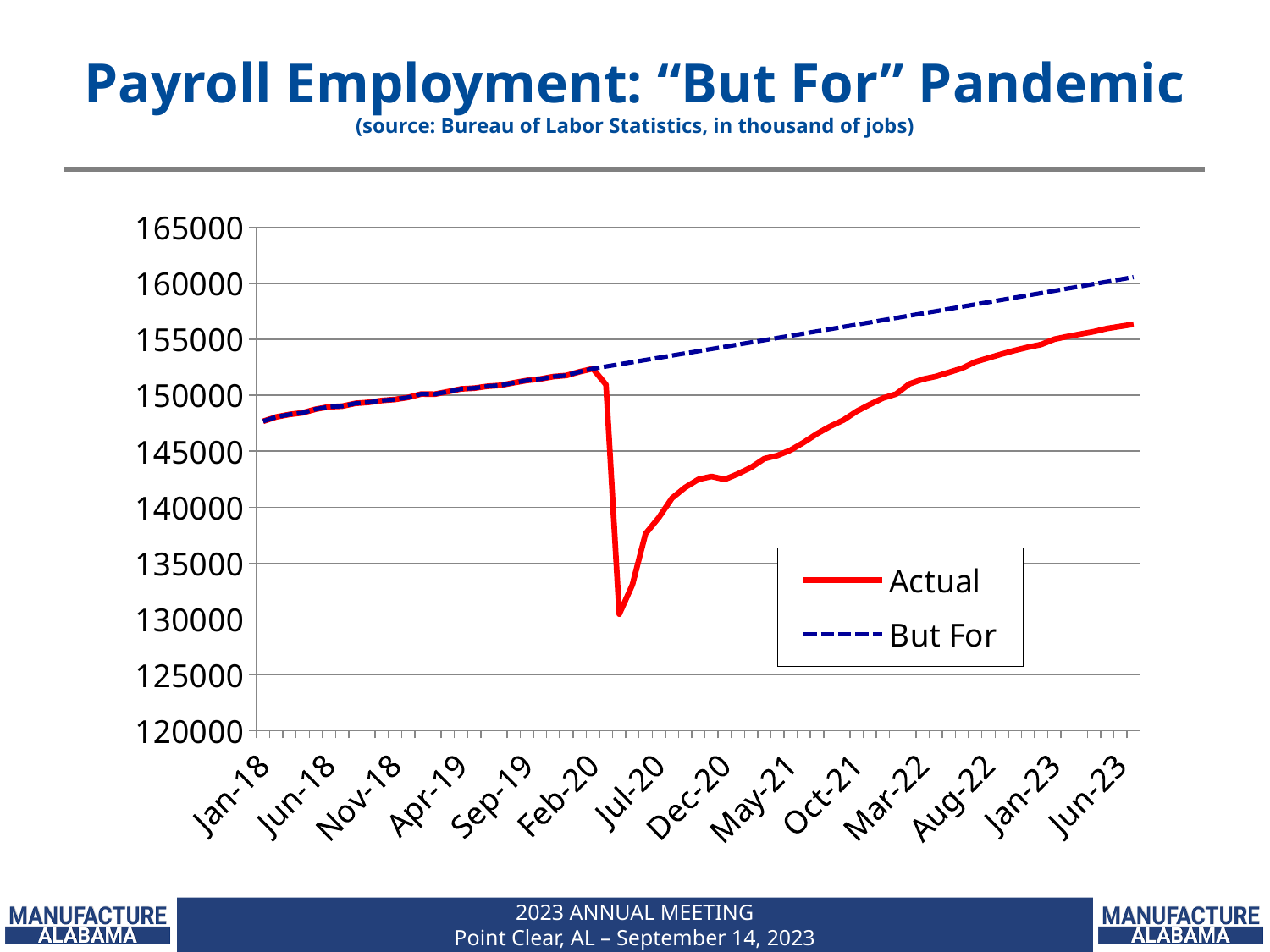
What kind of chart is shown on the slide? line chart Is the Actual value at Oct-21 greater or less than 150000? less What are the two series named in the legend? Actual and But For At Jun-23, which series has the higher value, Actual or But For? But For Does the But For series rise or fall from Jan-18 to Jun-23? rise Is the But For value at Jun-23 greater or less than 155000? greater Which series is drawn as a dashed line? But For Is the Actual value at Jun-23 greater or less than 155000? greater How many series does the legend list? 2